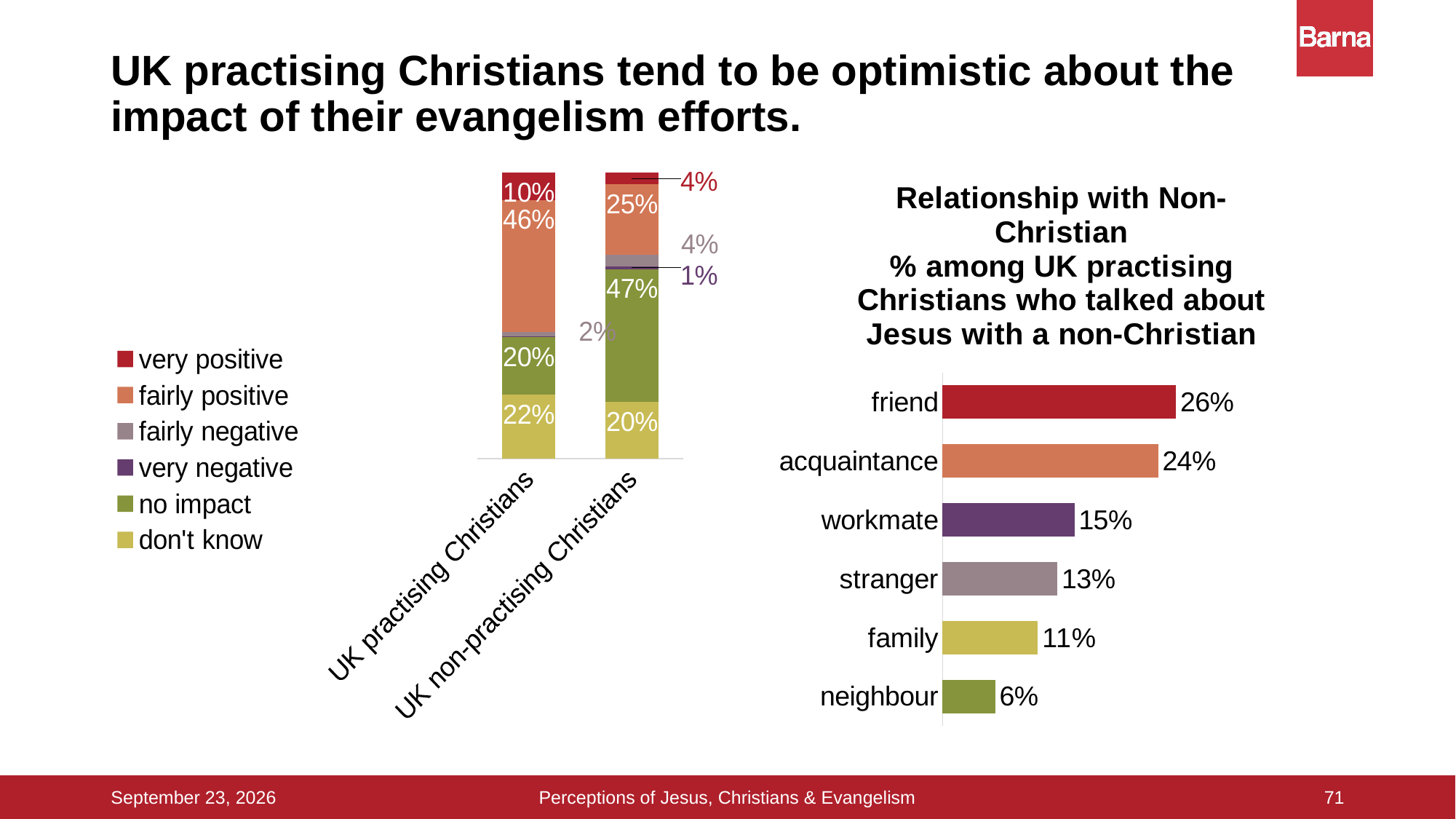
In the stacked bar chart on the left, what percentage of UK non-practising Christians said 'no impact'? 47% What kind of chart is the 'Relationship with Non-Christian' chart? bar chart In the 'Relationship with Non-Christian' chart, which relationship has the lowest percentage? neighbour In the stacked bar chart on the left, what is the difference between the 'don't know' percentages for UK practising Christians and UK non-practising Christians? 2% In the 'Relationship with Non-Christian' chart, what percentage is shown for friend? 26% In the 'Relationship with Non-Christian' chart, what percentage is shown for workmate? 15% In the stacked bar chart on the left, which group has the larger 'very positive' share, UK practising Christians or UK non-practising Christians? UK practising Christians In the 'Relationship with Non-Christian' chart, which relationship has the highest percentage? friend How many series does the legend of the stacked bar chart on the left list? 6 In the stacked bar chart on the left, what percentage of UK practising Christians said 'fairly positive'? 46% In the 'Relationship with Non-Christian' chart, how many relationship categories are shown? 6 In the 'Relationship with Non-Christian' chart, what is the difference between the percentages for acquaintance and stranger? 11%